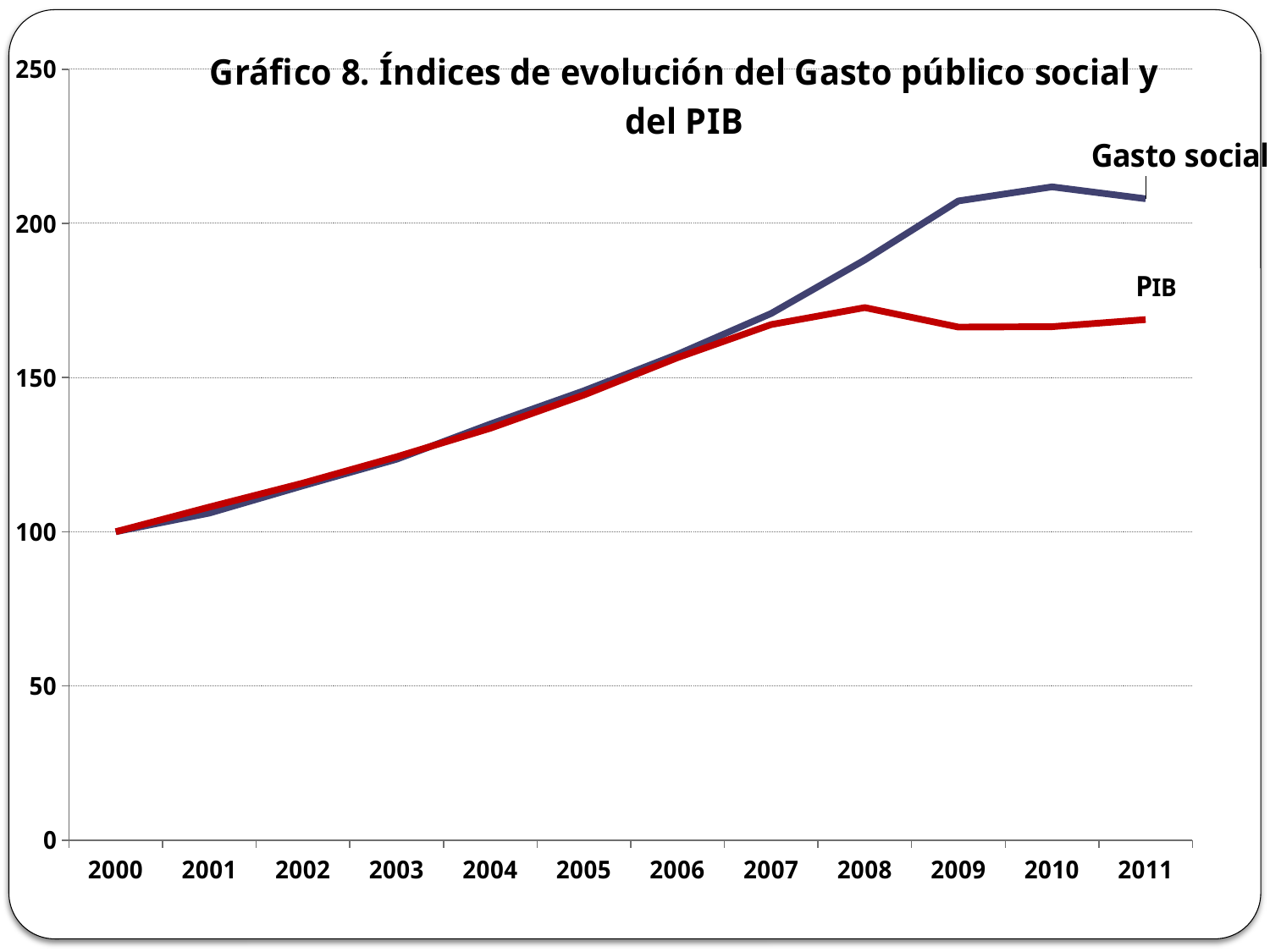
Is the value of Gasto social in 2004 greater or less than 150? less Is the value of PIB in 2008 greater or less than 150? greater Is the value of PIB in 2010 greater or less than 200? less How many series are plotted in the chart? 2 How many years are shown on the x axis? 12 What is the value of PIB in 2000? 100 Does the Gasto social line rise or fall between 2000 and 2010? rise What is the value of Gasto social in 2000? 100 What kind of chart is shown on the slide? line chart In 2011, which series has the higher value, Gasto social or PIB? Gasto social In which year does Gasto social reach its highest value? 2010